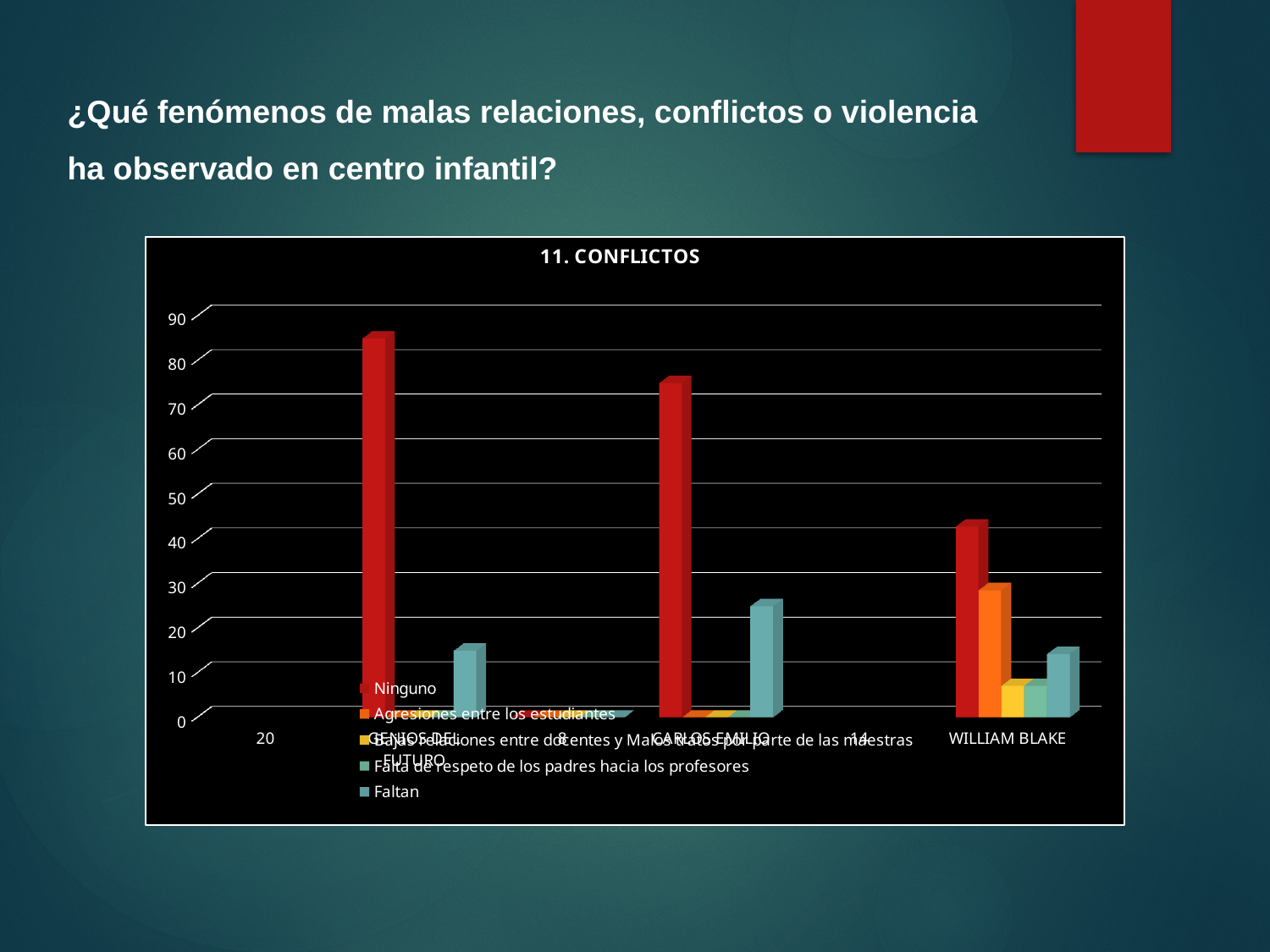
Which colour represents the 'Ninguno' series? red Is the 'Agresiones entre los estudiantes' value for WILLIAM BLAKE greater or less than 20? greater How many series does the legend list? 5 Which is larger, the 'Ninguno' value for CARLOS EMILIO or for WILLIAM BLAKE? CARLOS EMILIO Is the 'Faltan' value for GENIOS DEL FUTURO greater or less than 10? greater Is the 'Faltan' value for CARLOS EMILIO greater or less than 20? greater Which category has the highest 'Ninguno' value? GENIOS DEL FUTURO What is the title of the chart? 11. CONFLICTOS What kind of chart is shown on the slide? bar chart